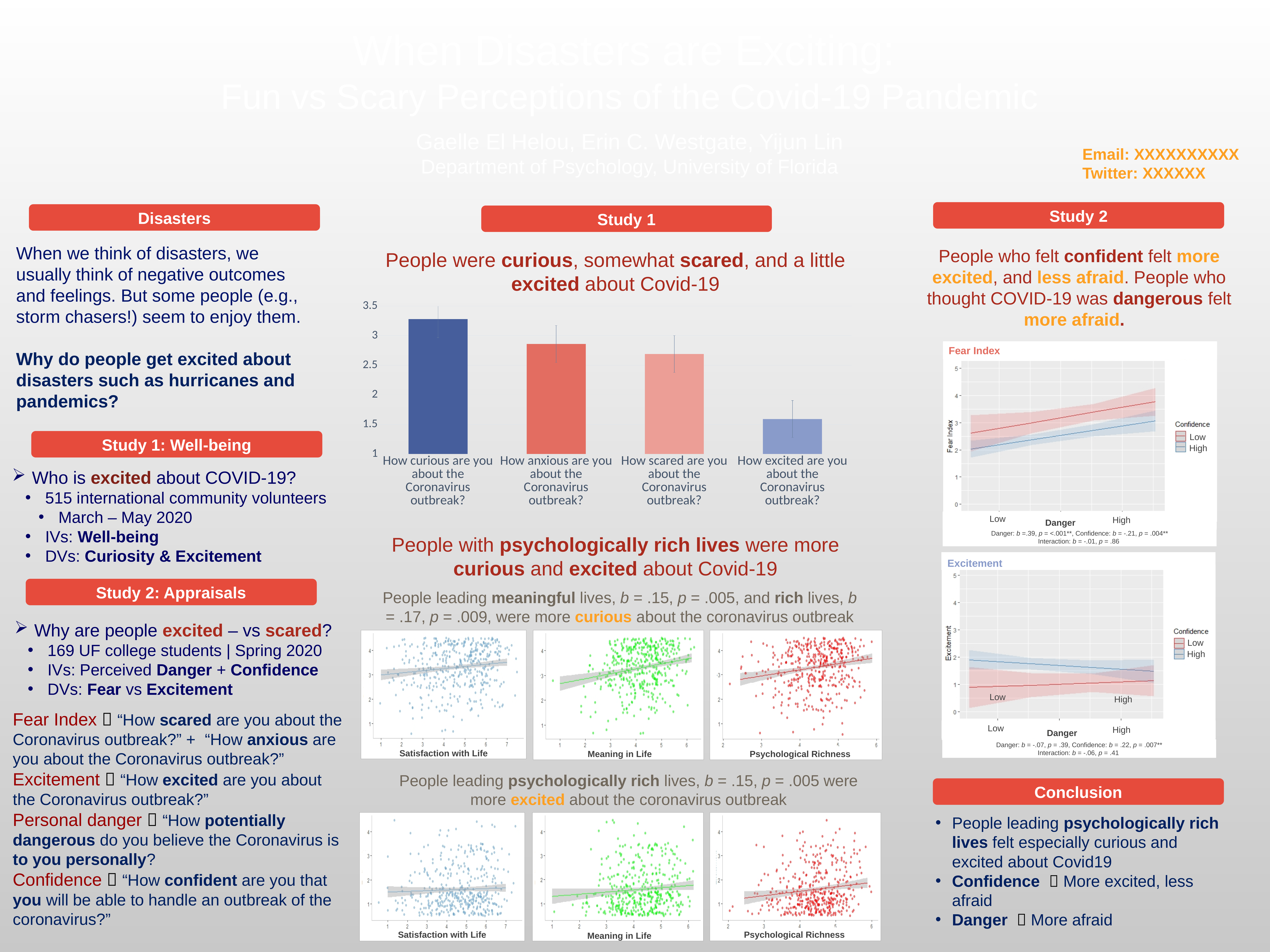
In the Study 1 bar chart, which category has the highest bar? How curious are you about the Coronavirus outbreak? What kind of chart is shown under the Study 1 heading, with the four 'How ... are you about the Coronavirus outbreak?' categories? bar chart In the 'Fear Index' line chart under Study 2, how many entries does the Confidence legend list? 2 In the 'Fear Index' line chart under Study 2, do the lines rise or fall as Danger goes from Low to High? rise In the Study 1 bar chart, how many bars (categories) are plotted? 4 In the Study 1 bar chart, is the value for 'How scared are you about the Coronavirus outbreak?' greater or less than 2.5? greater In the Study 1 bar chart, what is the highest value shown on the vertical axis? 3.5 In the Study 1 bar chart, is the value for 'How curious are you about the Coronavirus outbreak?' greater or less than 3? greater In the Study 1 bar chart, is the value for 'How excited are you about the Coronavirus outbreak?' greater or less than 2? less In the Study 1 bar chart, which category has the lowest bar? How excited are you about the Coronavirus outbreak? In the 'Excitement' line chart under Study 2, which Confidence group has the higher line: Low or High? High In the Study 1 bar chart, which is larger: the value for 'How anxious are you' or the value for 'How excited are you'? How anxious are you